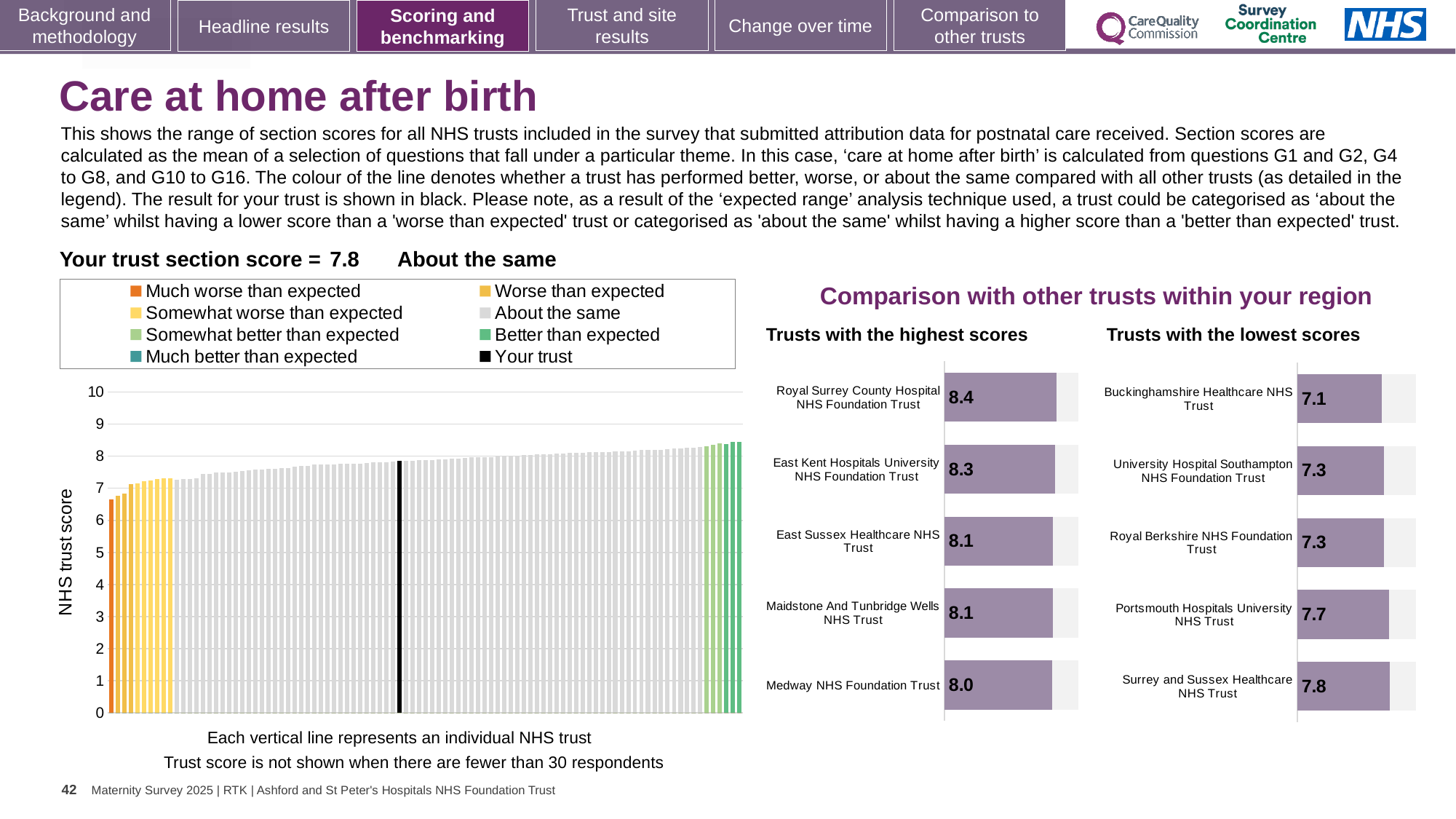
How many entries does the legend above the 'NHS trust score' chart list? 8 In the 'NHS trust score' chart on the left, is the value of the tallest bar greater or less than 9? less In the 'Trusts with the lowest scores' chart, which has the higher score: Portsmouth Hospitals University NHS Trust or Surrey and Sussex Healthcare NHS Trust? Surrey and Sussex Healthcare NHS Trust In the 'Trusts with the highest scores' chart, which trust has the highest score? Royal Surrey County Hospital NHS Foundation Trust How many trusts are shown in the 'Trusts with the highest scores' chart? 5 What kind of chart is the 'NHS trust score' chart on the left of the slide? bar chart In the 'Trusts with the highest scores' chart, what is the score for Royal Surrey County Hospital NHS Foundation Trust? 8.4 In the 'Trusts with the highest scores' chart, what is the score for Medway NHS Foundation Trust? 8.0 In the 'Trusts with the lowest scores' chart, what is the score for Buckinghamshire Healthcare NHS Trust? 7.1 In the 'Trusts with the lowest scores' chart, which trust has the lowest score? Buckinghamshire Healthcare NHS Trust In the 'Trusts with the highest scores' chart, what is the difference between the scores of Royal Surrey County Hospital NHS Foundation Trust and Medway NHS Foundation Trust? 0.4 In the 'NHS trust score' chart on the left, do the bar values rise or fall from left to right? rise